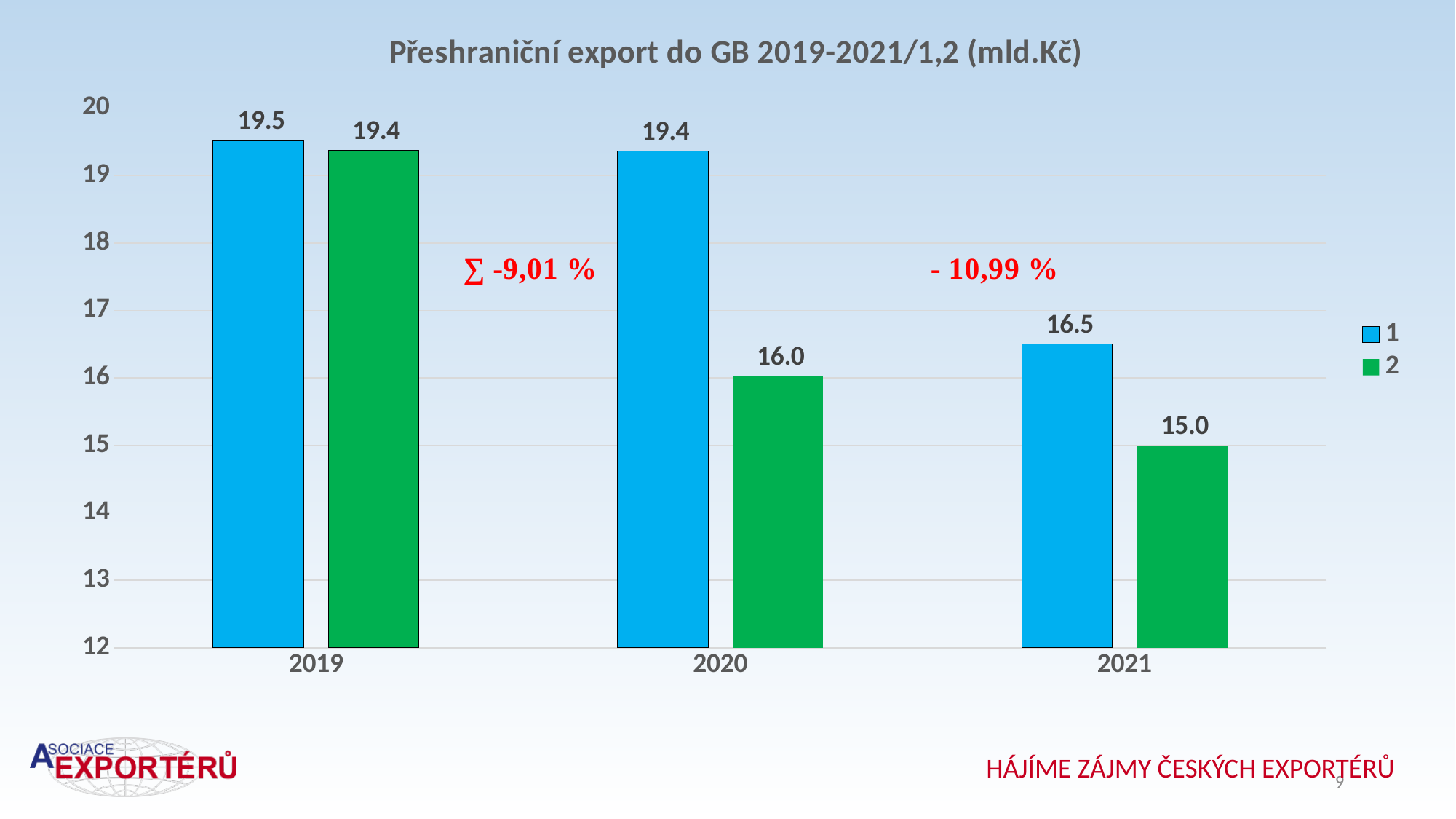
What is the value of series 1 for 2019? 19.5 How many series does the legend list? 2 How many years are shown on the x axis? 3 Which year has the lowest value for series 1? 2021 What is the difference between series 1 and series 2 in 2020? 3.4 What kind of chart is shown on the slide? bar chart What is the value of series 2 for 2020? 16.0 Which is larger in 2021, series 1 or series 2? series 1 Do the values for series 2 rise or fall from 2019 to 2021? fall What is the value of series 2 for 2021? 15.0 What is the difference between the series 1 values for 2019 and 2021? 3.0 Which year has the highest value for series 2? 2019